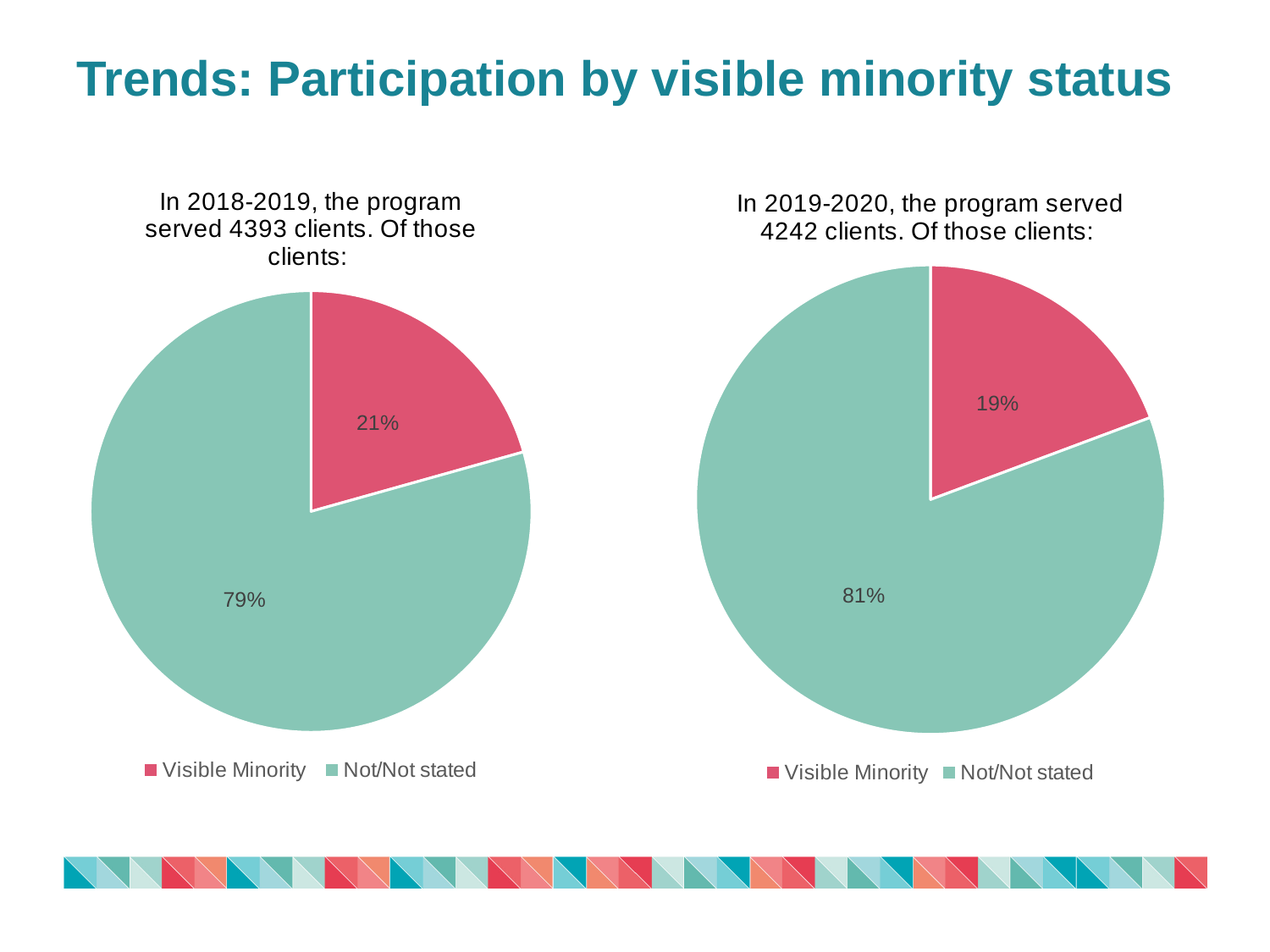
Comparing the two pie charts, was the Visible Minority share larger in 2018-2019 or in 2019-2020? 2018-2019 How many slices does the right pie chart (2019-2020) have? 2 In the right pie chart (2019-2020), which category has the smallest slice? Visible Minority How many entries does the legend of the left pie chart (2018-2019) list? 2 In the right pie chart (2019-2020), what share of clients were Visible Minority? 19% In the left pie chart (2018-2019), which category has the largest slice? Not/Not stated In the right pie chart (2019-2020), what colour is the Visible Minority slice? Red/pink In the left pie chart (2018-2019), what share of clients were Not/Not stated? 79% In the left pie chart (2018-2019), what share of clients were Visible Minority? 21% In the left pie chart (2018-2019), what is the difference in percentage points between the Not/Not stated and Visible Minority slices? 58 What type of chart is used on the left side of the slide? Pie chart In the right pie chart (2019-2020), what share of clients were Not/Not stated? 81%